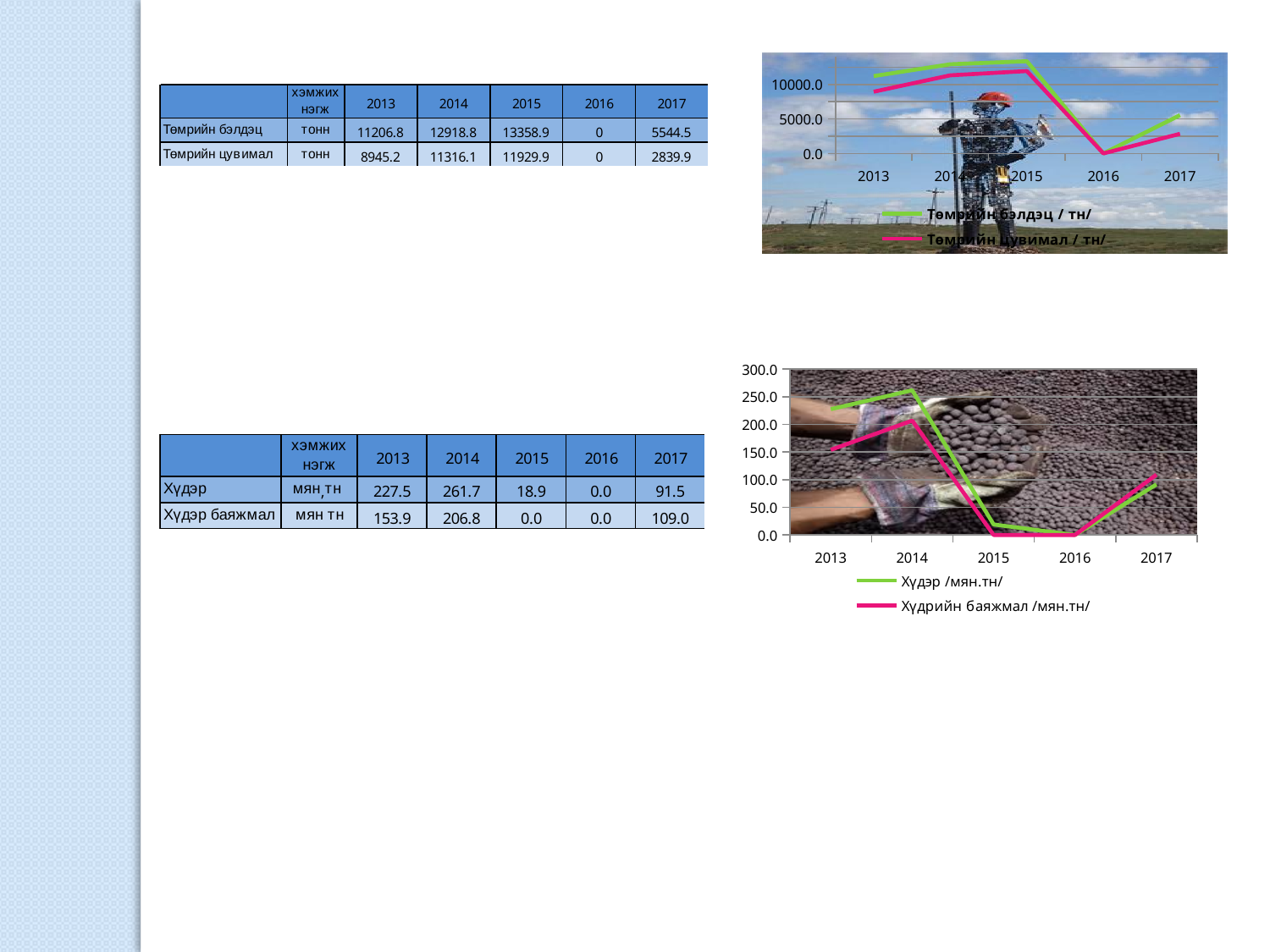
In the top chart, what is the value of Төмрийн бэлдэц for 2015? 13358.9 In the top chart, in which year is Төмрийн бэлдэц highest? 2015 In the bottom chart, is the value for Хүдэр in 2014 greater or less than 250.0? greater In the top chart, does Төмрийн бэлдэц rise or fall from 2015 to 2016? fall In the bottom chart, what is the difference between Хүдэр and Хүдэр баяжмал in 2014? 54.9 In the bottom chart, what is the value of Хүдэр баяжмал for 2017? 109.0 In the bottom chart, which series has the larger value in 2013, Хүдэр or Хүдэр баяжмал? Хүдэр How many years are shown on the x axis of the top chart? 5 In the bottom chart, in which year is Хүдэр lowest? 2016 In the top chart, is the value for Төмрийн цувимал in 2017 greater or less than 5000.0? less How many series does the legend of the bottom chart list? 2 What kind of chart is the top chart on the slide? line chart